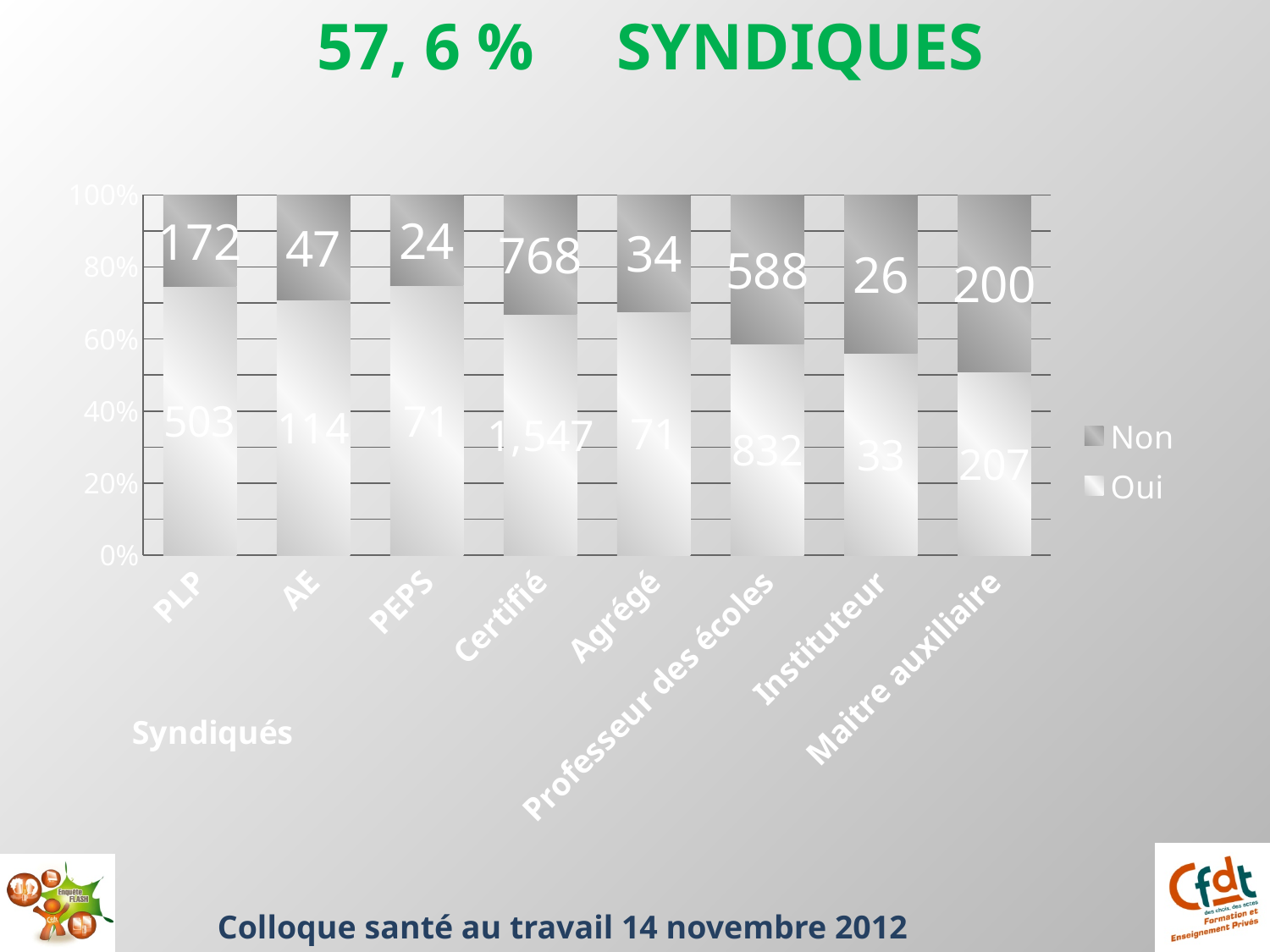
Which is larger for Instituteur, the Oui value or the Non value? Oui What kind of chart is shown on the slide? Stacked bar chart What is the value for Non for PLP? 172 How many series does the legend list? 2 What is the value for Oui for Professeur des écoles? 832 What is the value for Oui for Certifié? 1,547 Which category has the lowest value for Non? PEPS What is the total of the stacked bar for PLP (Oui plus Non)? 675 What is the difference between the Oui and Non values for Agrégé? 37 Which category has the highest value for Oui? Certifié How many categories are shown on the x axis? 8 What is the value for Non for Maitre auxiliaire? 200